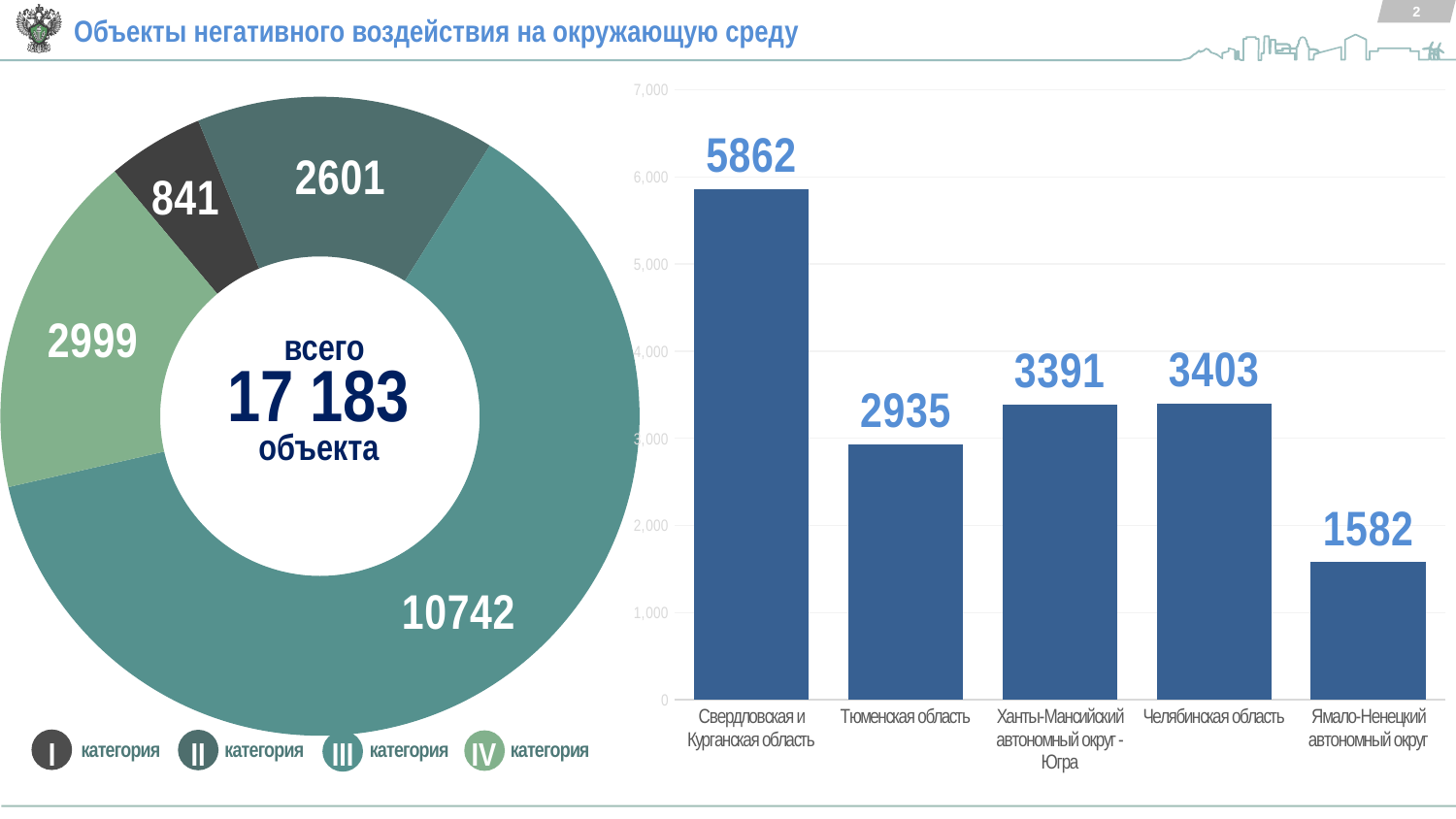
In the bar chart on the right, what is the difference between Свердловская и Курганская область and Ямало-Ненецкий автономный округ? 4280 In the donut chart on the left, what total number of objects is shown in the centre? 17 183 In the bar chart on the right, which region has the lowest value? Ямало-Ненецкий автономный округ How many categories does the legend of the donut chart on the left list? 4 In the donut chart on the left, what is the value of the largest segment? 10742 What type of chart is on the right side of the slide? bar chart In the bar chart on the right, which is larger: Челябинская область or Ханты-Мансийский автономный округ - Югра? Челябинская область In the donut chart on the left, what is the difference between the segments labelled 2999 and 2601? 398 What type of chart is on the left side of the slide? pie chart (donut) In the bar chart on the right, what is the value for Тюменская область? 2935 In the donut chart on the left, what is the value of the smallest segment? 841 In the bar chart on the right, which region has the highest value? Свердловская и Курганская область